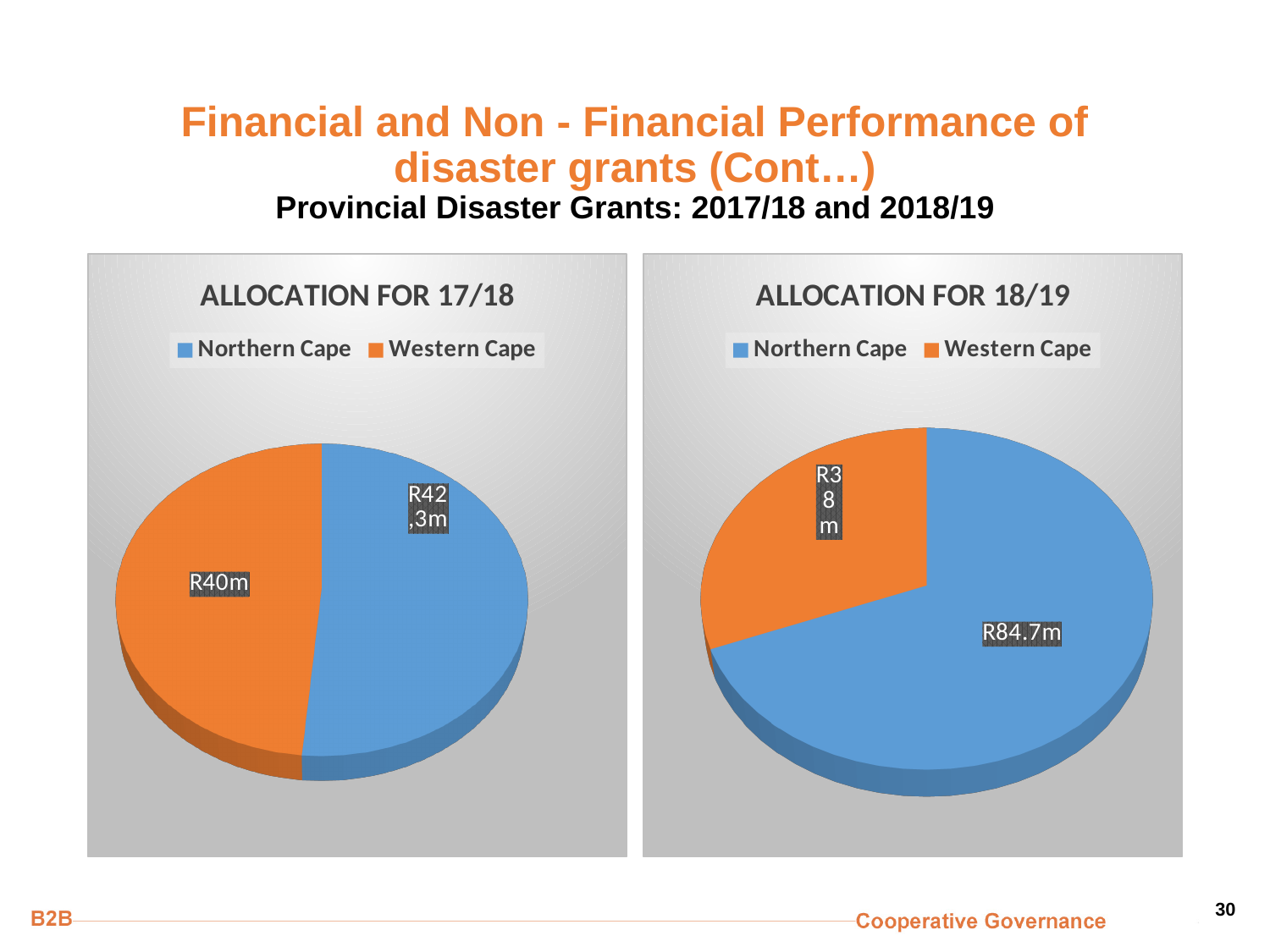
What type of chart is the 'ALLOCATION FOR 18/19' chart? Pie chart In the 'ALLOCATION FOR 17/18' chart, what is the value for Western Cape? R40m In the 'ALLOCATION FOR 18/19' chart, what is the value for Northern Cape? R84.7m In the 'ALLOCATION FOR 18/19' chart, how much larger is the Northern Cape allocation than the Western Cape allocation? R46.7m In the 'ALLOCATION FOR 17/18' chart, which colour represents Western Cape? Orange In the 'ALLOCATION FOR 17/18' chart, what is the value for Northern Cape? R42,3m In the 'ALLOCATION FOR 18/19' chart, which province has the smallest allocation? Western Cape In the 'ALLOCATION FOR 18/19' chart, which province has the largest allocation? Northern Cape In the 'ALLOCATION FOR 17/18' chart, which province has the larger allocation, Northern Cape or Western Cape? Northern Cape How many entries does the legend of the 'ALLOCATION FOR 18/19' chart list? 2 In the 'ALLOCATION FOR 18/19' chart, what is the value for Western Cape? R38m How many slices does the 'ALLOCATION FOR 17/18' pie chart have? 2